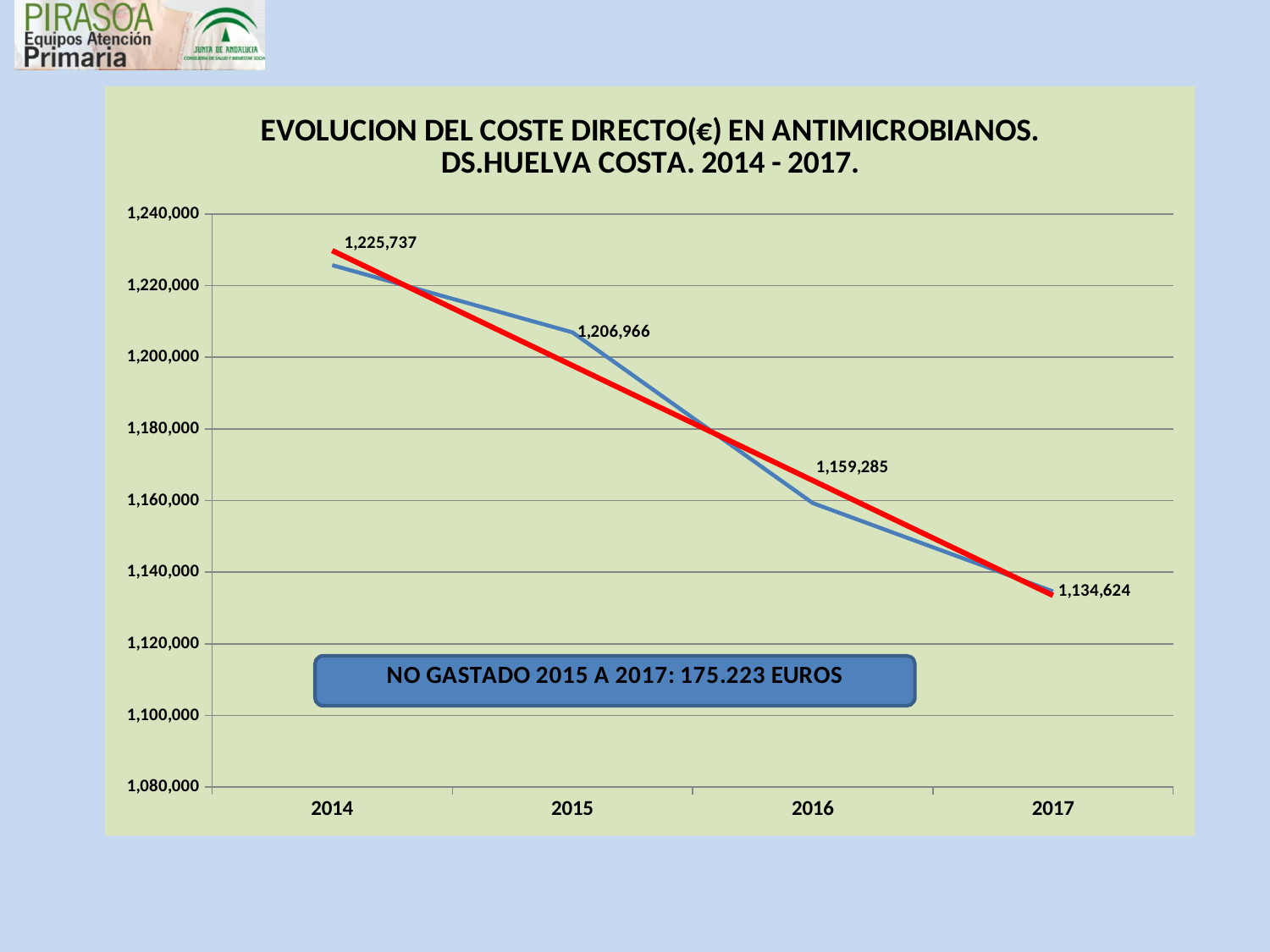
Which is larger, the value for 2015 or the value for 2016? 2015 What is the difference between the 2015 value and the 2016 value? 47,681 What was the direct cost of antimicrobials in 2014? 1,225,737 Do the values rise or fall from 2014 to 2017? fall What is the difference between the 2014 value and the 2017 value? 91,113 What kind of chart is shown on the slide? line chart Which year has the highest direct cost? 2014 How many years are plotted on the x axis? 4 What value is shown for 2017? 1,134,624 What value is shown for 2016? 1,159,285 Which year has the lowest direct cost? 2017 Is the value for 2015 greater or less than 1,200,000? greater